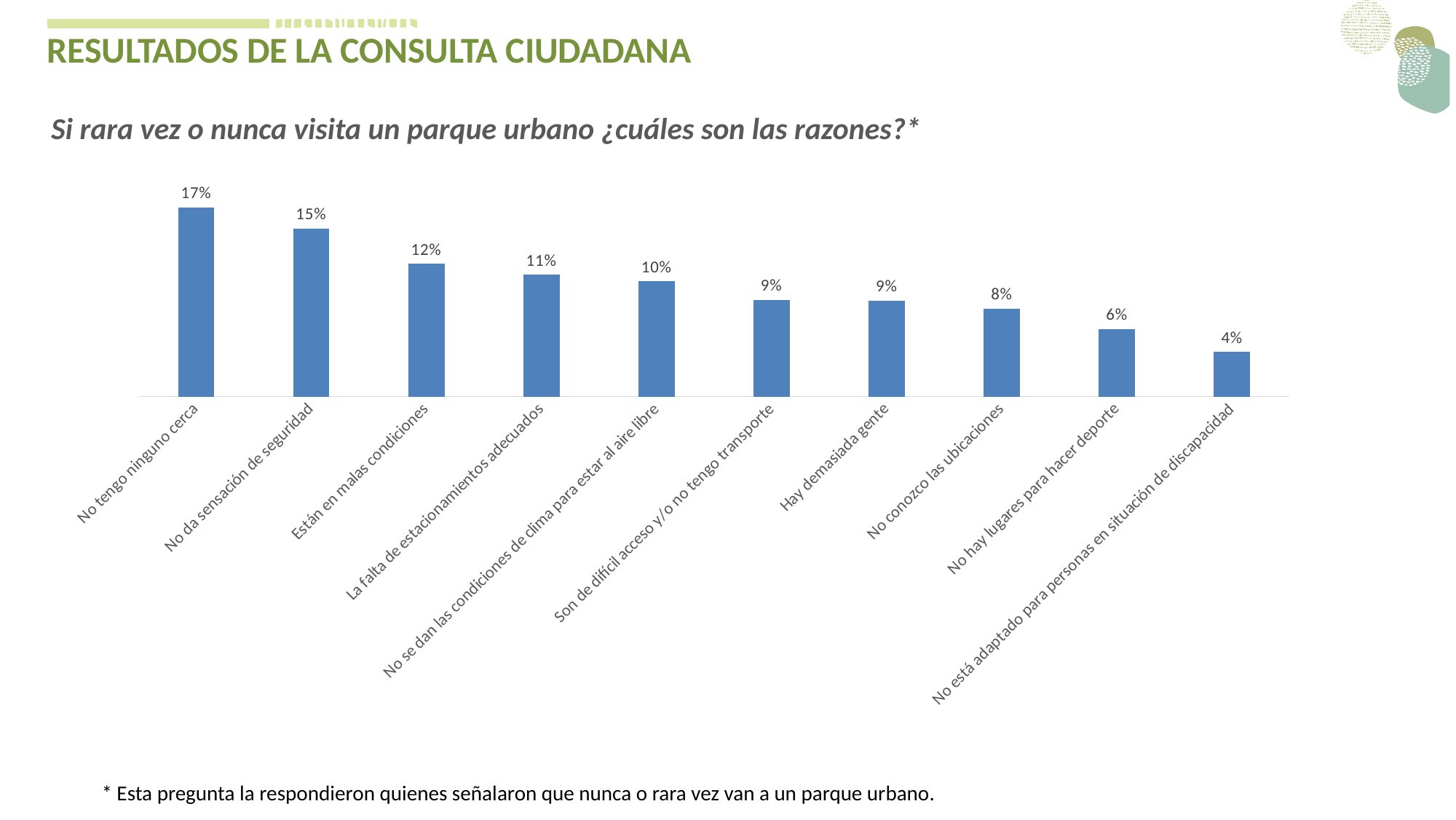
What is the difference between the values for "La falta de estacionamientos adecuados" and "No está adaptado para personas en situación de discapacidad"? 7% What is the difference between the values for "No tengo ninguno cerca" and "No da sensación de seguridad"? 2% How many categories are shown in the chart? 10 What kind of chart is shown on the slide? Bar chart Which category has the highest value? No tengo ninguno cerca Do the values rise or fall from left to right along the x axis? Fall Which is larger, the value for "No se dan las condiciones de clima para estar al aire libre" or the value for "No conozco las ubicaciones"? No se dan las condiciones de clima para estar al aire libre What is the value for "No tengo ninguno cerca"? 17% What is the value for "No hay lugares para hacer deporte"? 6% What is the value for "Están en malas condiciones"? 12% Which category has the lowest value? No está adaptado para personas en situación de discapacidad What is the value for "No conozco las ubicaciones"? 8%